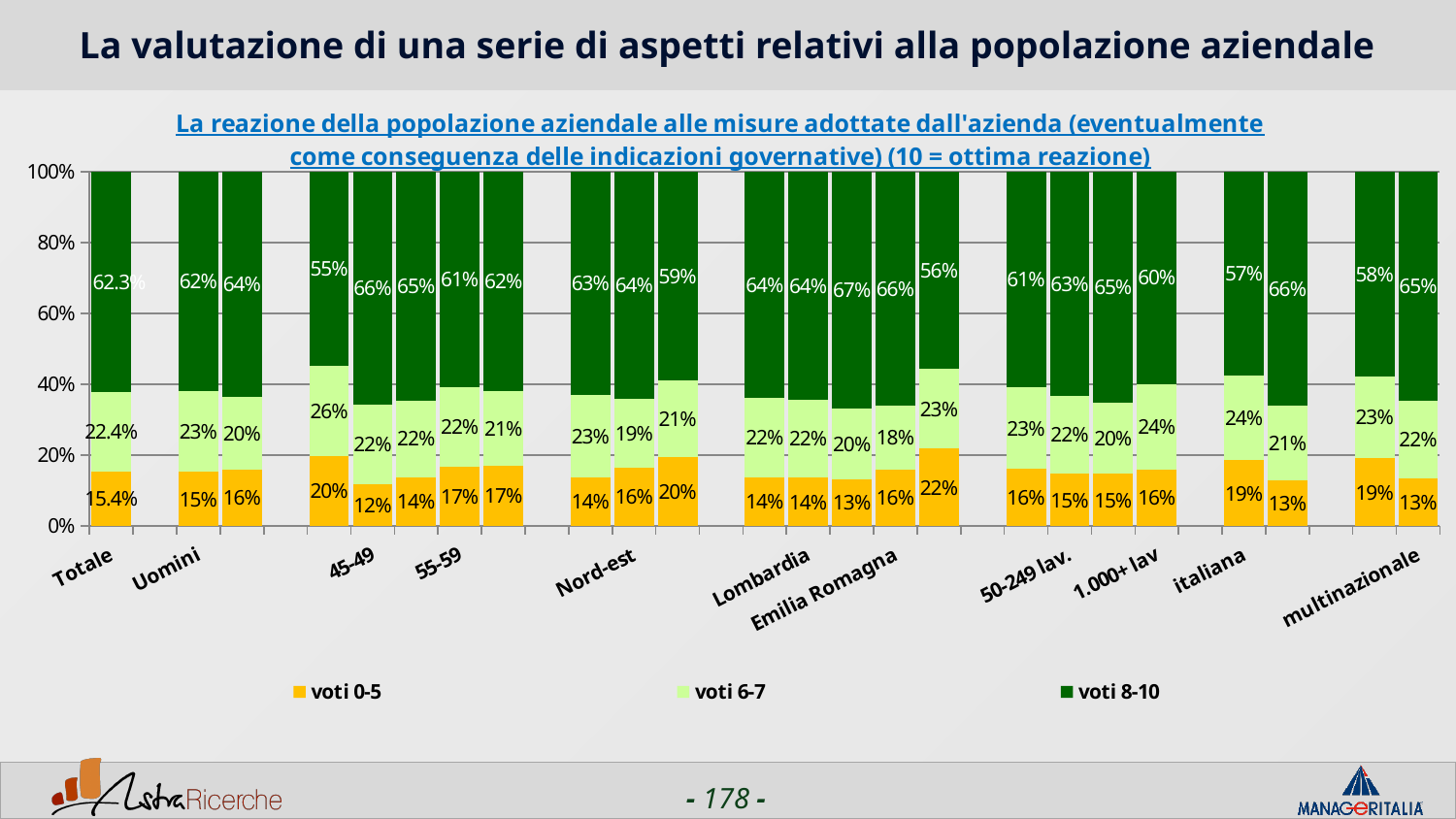
Which has the larger 'voti 0-5' value, 'italiana' or 'multinazionale'? italiana What is the value of the 'voti 0-5' series for 'Nord-est'? 16% What is the difference between the 'voti 8-10' values for 'multinazionale' and 'italiana'? 8 percentage points Which has the larger 'voti 8-10' value, 'Lombardia' or 'Emilia Romagna'? Emilia Romagna What is the value of the 'voti 6-7' series for '1.000+ lav'? 24% What is the value of the 'voti 8-10' series for the 'Totale' bar? 62.3% How many series does the legend list? 3 What is the value of the 'voti 0-5' series for the '45-49' age group? 12% What kind of chart is shown on the slide? Stacked bar chart What is the value of the 'voti 8-10' series for 'italiana'? 57% What are the three legend entries of the chart? voti 0-5, voti 6-7, voti 8-10 What is the value of the 'voti 6-7' series for 'Emilia Romagna'? 18%